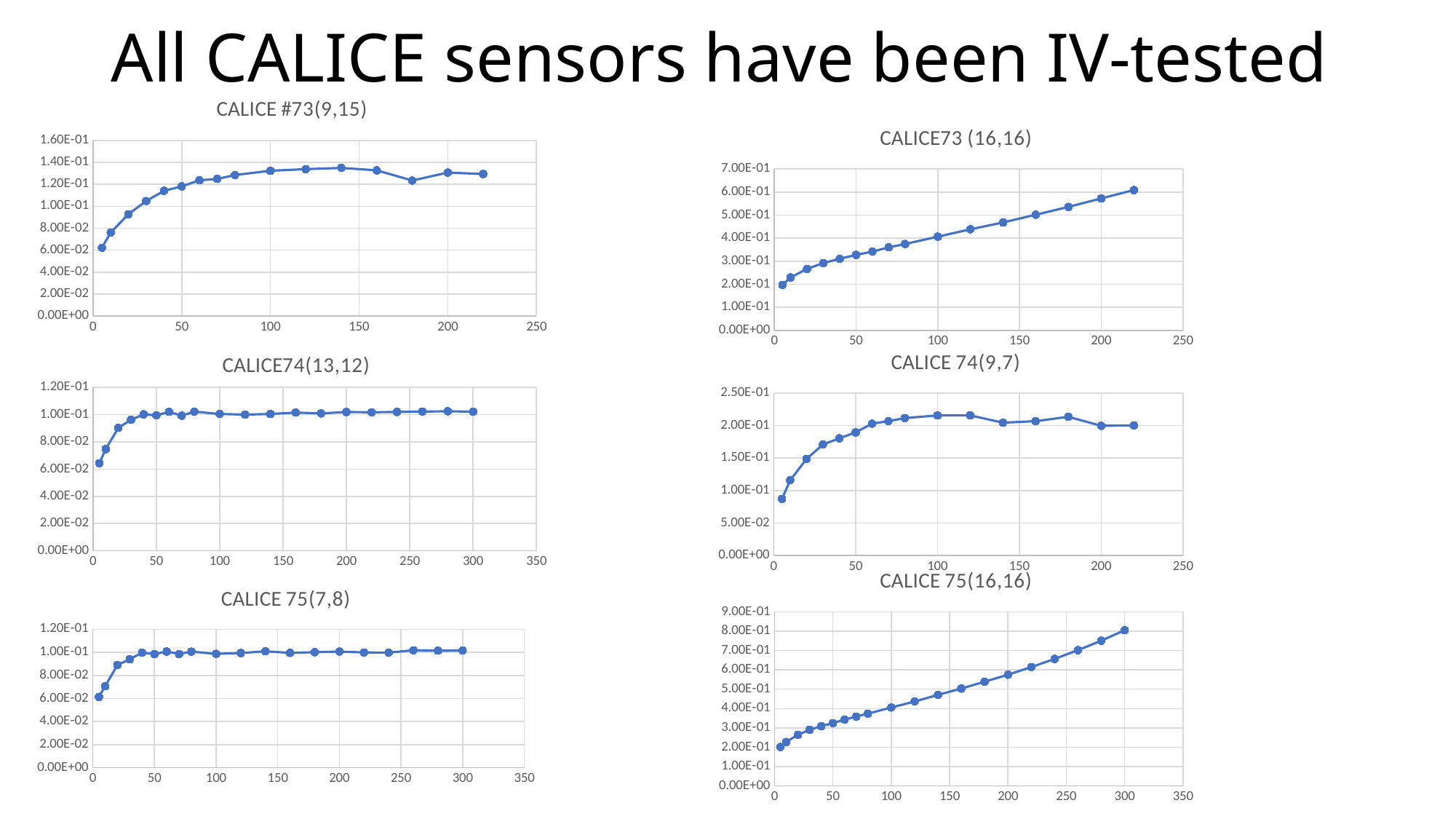
In the CALICE73 (16,16) chart, is the value at x = 220 greater or less than 5.00E-01? greater What kind of chart is CALICE73 (16,16)? line chart In the CALICE 74(9,7) chart, is the value at x = 100 greater or less than 1.50E-01? greater How many charts are shown on the slide? 6 What is the highest tick shown on the y axis of the CALICE 75(16,16) chart? 9.00E-01 In the CALICE 75(16,16) chart, is the value at x = 300 greater or less than 7.00E-01? greater In the CALICE 75(16,16) chart, at which x value is the plotted value highest? 300 In the CALICE73 (16,16) chart, do the values rise or fall as x increases? rise In the CALICE #73(9,15) chart, at which x value is the plotted value lowest? 5 In the CALICE 75(16,16) chart, do the values rise or fall along the x axis? rise